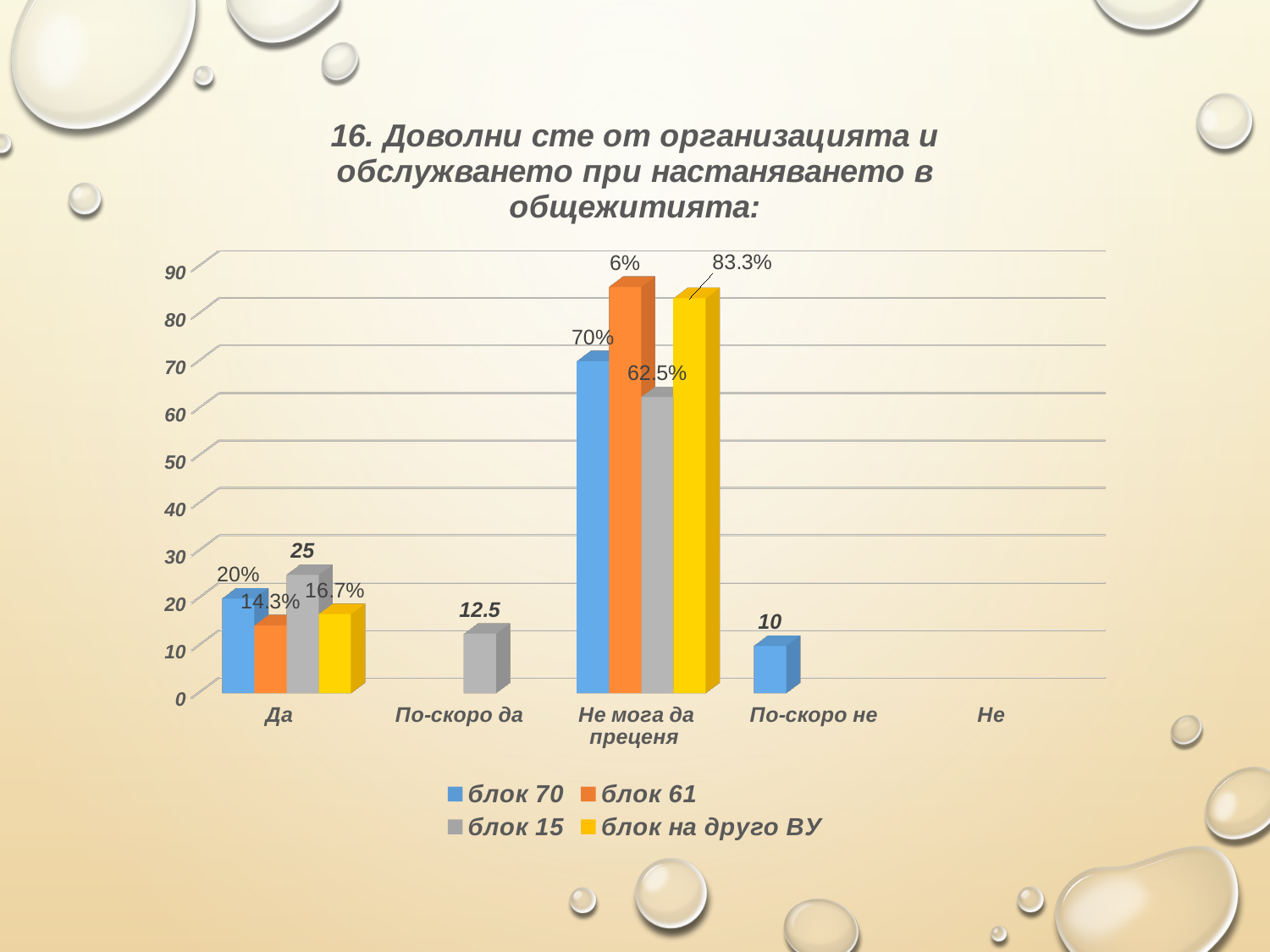
What is the value for блок 70 in the Да category? 20% How many series does the legend list? 4 What is the value for блок 15 in the По-скоро да category? 12.5 In the Да category, what is the difference between the values for блок 70 and блок 61? 5.7% Is the value for блок 61 in the Не мога да преценя category greater or less than 80? greater What kind of chart is shown on the slide? bar chart What is the value for блок на друго ВУ in the Не мога да преценя category? 83.3% In the Да category, which series has the highest value? блок 15 What is the value for блок 70 in the По-скоро не category? 10 In the Не мога да преценя category, which is larger: блок 70 or блок 15? блок 70 How many categories are shown on the x axis? 5 What is the value for блок 15 in the Да category? 25